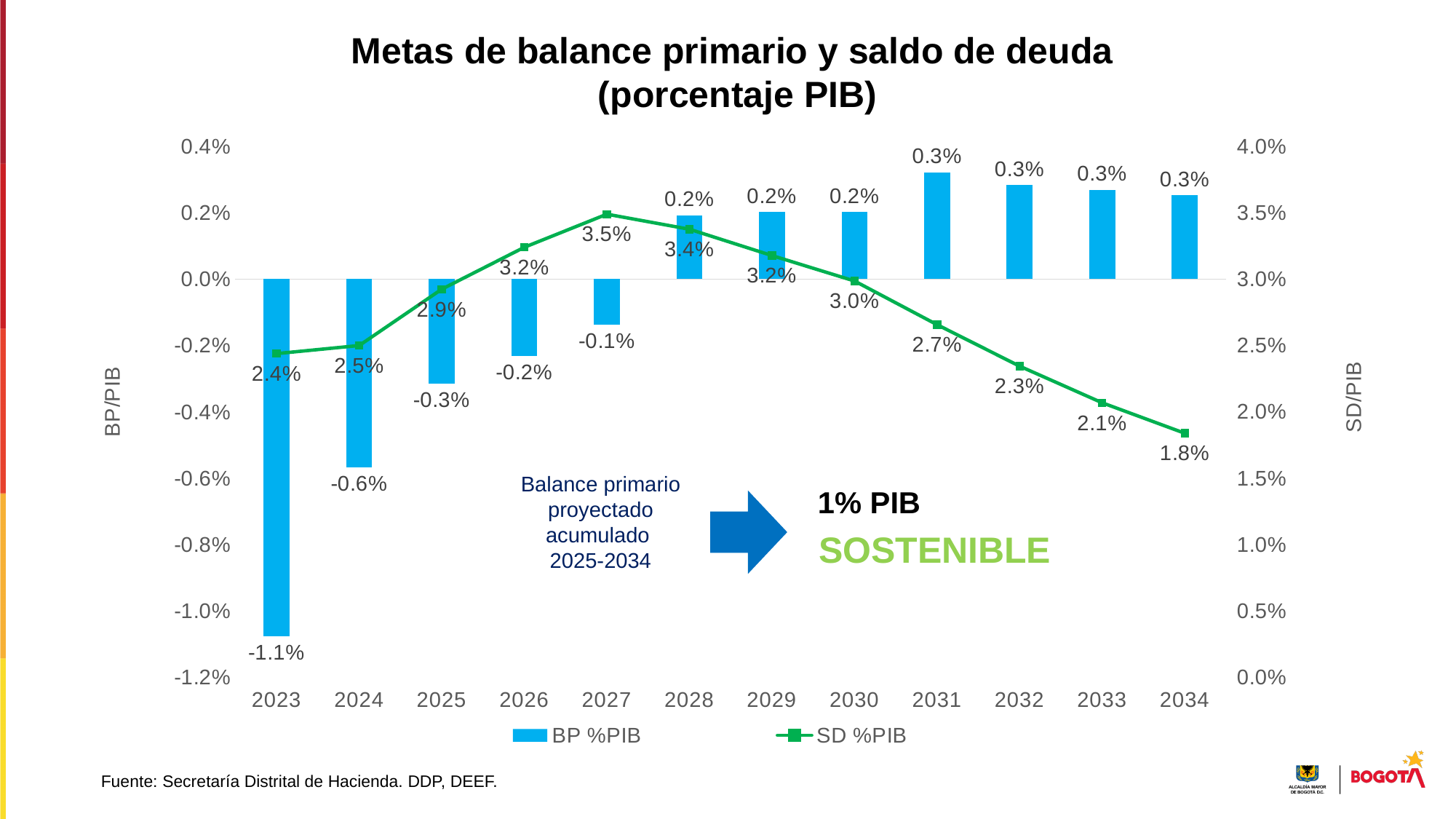
What is the SD %PIB value for 2027? 3.5% In which year is the BP %PIB bar lowest? 2023 By how many percentage points does SD %PIB fall from 2027 to 2034? 1.7 percentage points Does the SD %PIB line rise or fall from 2027 to 2034? Fall What kind of chart is this? A combined bar and line chart What is the SD %PIB value for 2034? 1.8% How many series does the legend list? 2 In which year does the SD %PIB line reach its highest value? 2027 What is the label of the right-hand vertical axis? SD/PIB Which year has a higher SD %PIB value, 2024 or 2030? 2030 What is the BP %PIB value for 2023? -1.1% How many years are shown on the x axis? 12